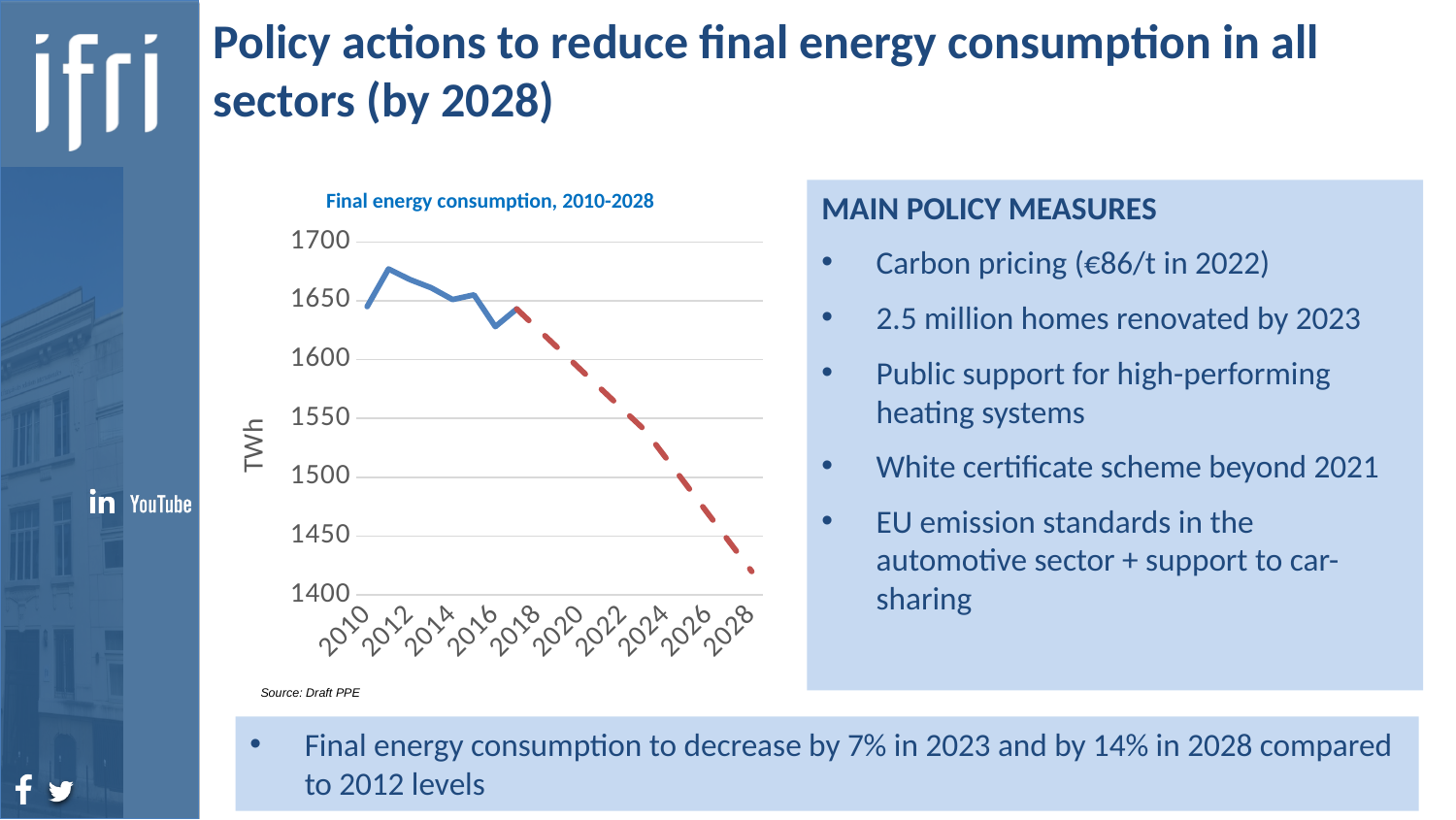
Is the value for 2010 greater or less than 1600? greater Is the value for 2024 greater or less than 1550? less Which year shown on the x axis has the lowest final energy consumption? 2028 Is the value for 2028 greater or less than 1450? less Which is larger, the value for 2014 or the value for 2024? 2014 What kind of chart is shown on the slide? line chart What is the title of the chart? Final energy consumption, 2010-2028 What unit is shown on the y axis of the chart? TWh Does final energy consumption rise or fall overall between 2010 and 2028 in the chart? fall How many year labels are shown on the x axis of the chart? 10